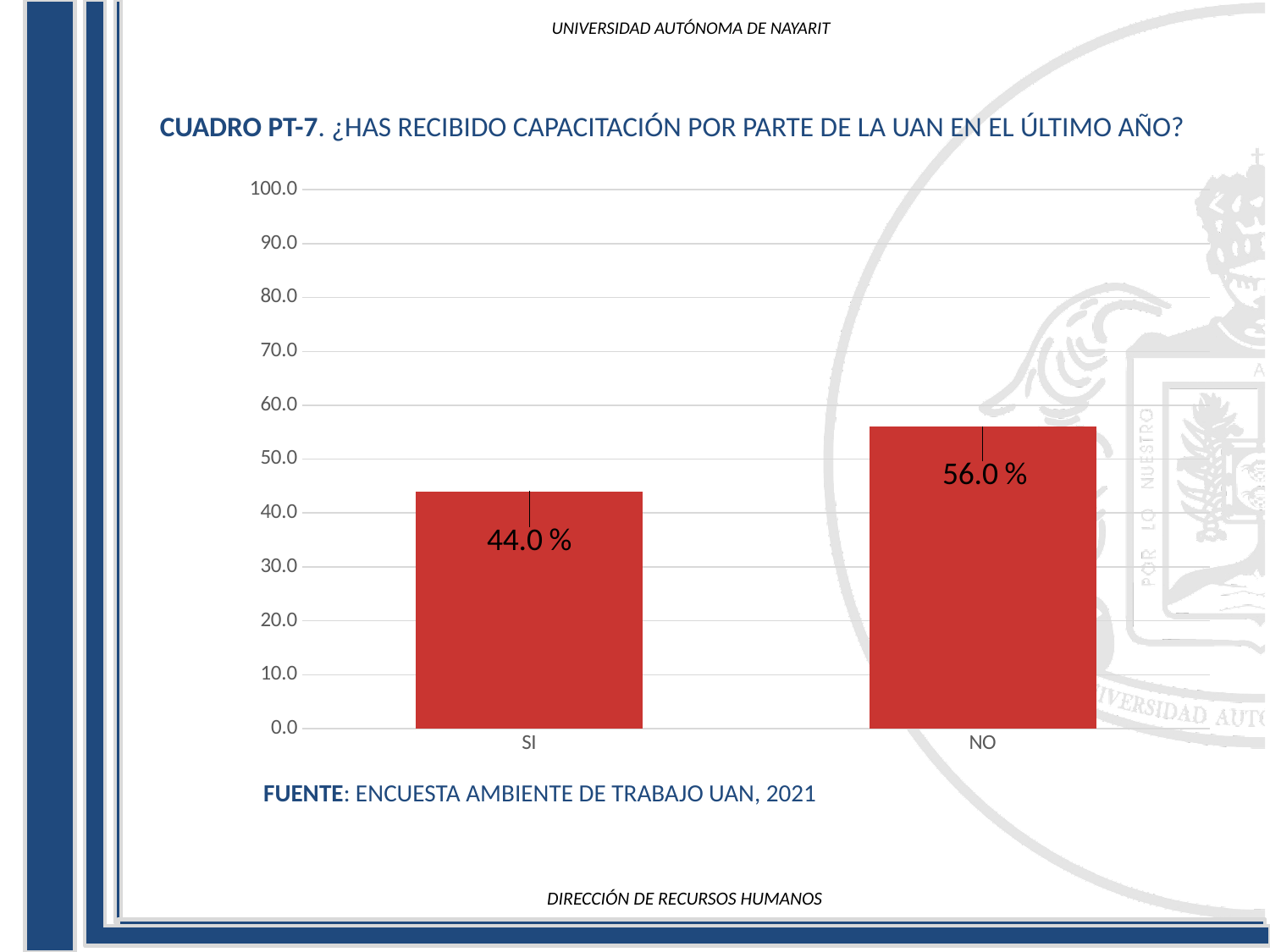
Is the value for NO greater or less than 50.0? greater Is the value for SI greater or less than 50.0? less Which is larger, the value for SI or the value for NO? NO Which category has the lowest value? SI What is the maximum value shown on the y axis? 100.0 What is the difference between the values for NO and SI? 12.0 % What is the source cited below the chart? ENCUESTA AMBIENTE DE TRABAJO UAN, 2021 Which category has the highest value? NO How many categories are shown on the x axis? 2 What is the value for SI? 44.0 % What is the value for NO? 56.0 % What kind of chart is shown on the slide? bar chart